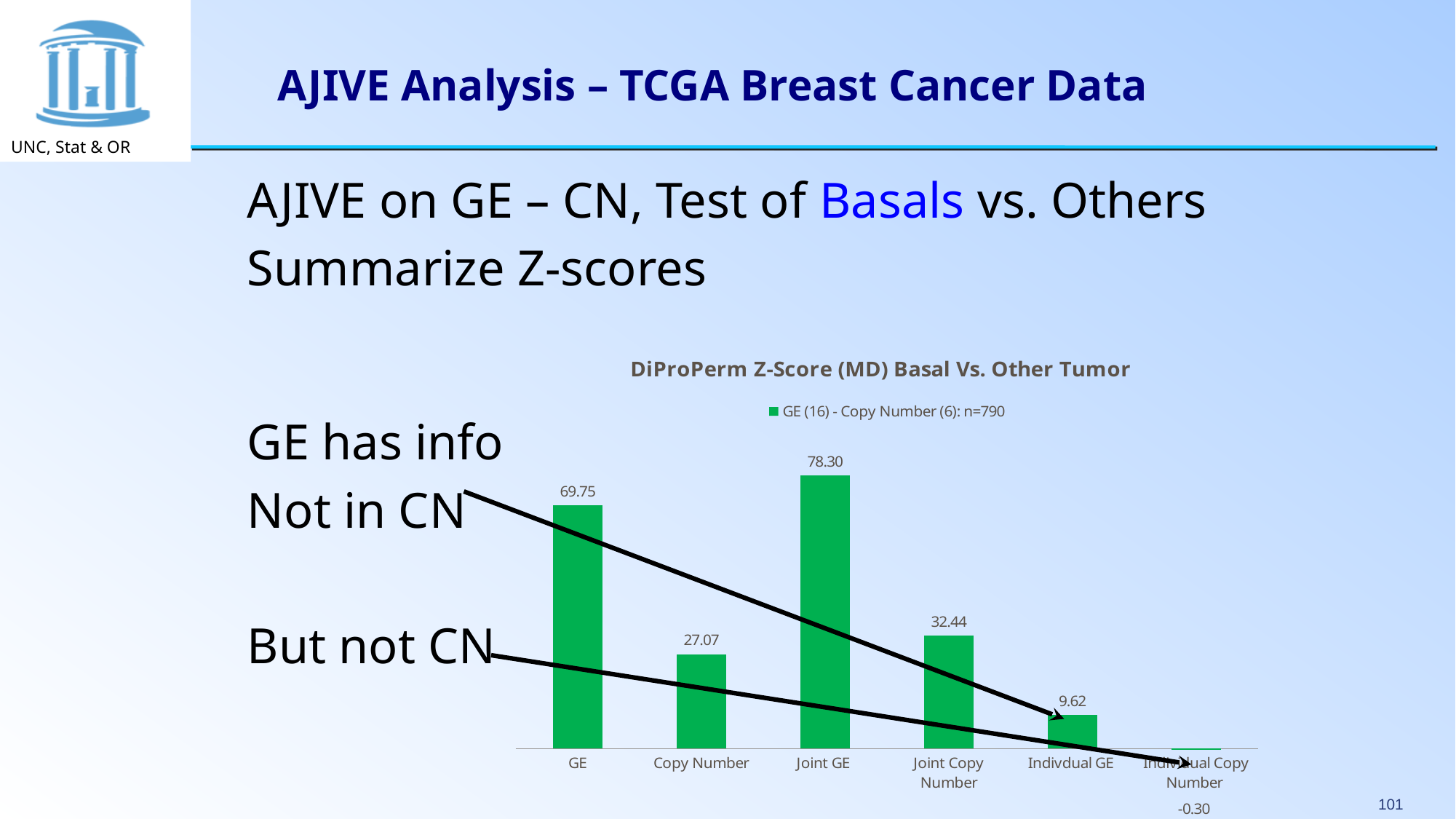
Which category has the lowest Z-score? Individual Copy Number What is the title of the chart? DiProPerm Z-Score (MD) Basal Vs. Other Tumor Which has a larger Z-score, Joint Copy Number or Individual GE? Joint Copy Number What is the Z-score value for Copy Number? 27.07 What is the Z-score value for GE? 69.75 What is the difference between the Z-scores for Joint GE and GE? 8.55 What is the difference between the Z-scores for Joint Copy Number and Copy Number? 5.37 What is the Z-score value for Joint GE? 78.30 What is the Z-score value for Individual Copy Number? -0.30 How many categories are shown on the x axis of the chart? 6 Which category has the highest Z-score? Joint GE What kind of chart is shown on the slide? Bar chart